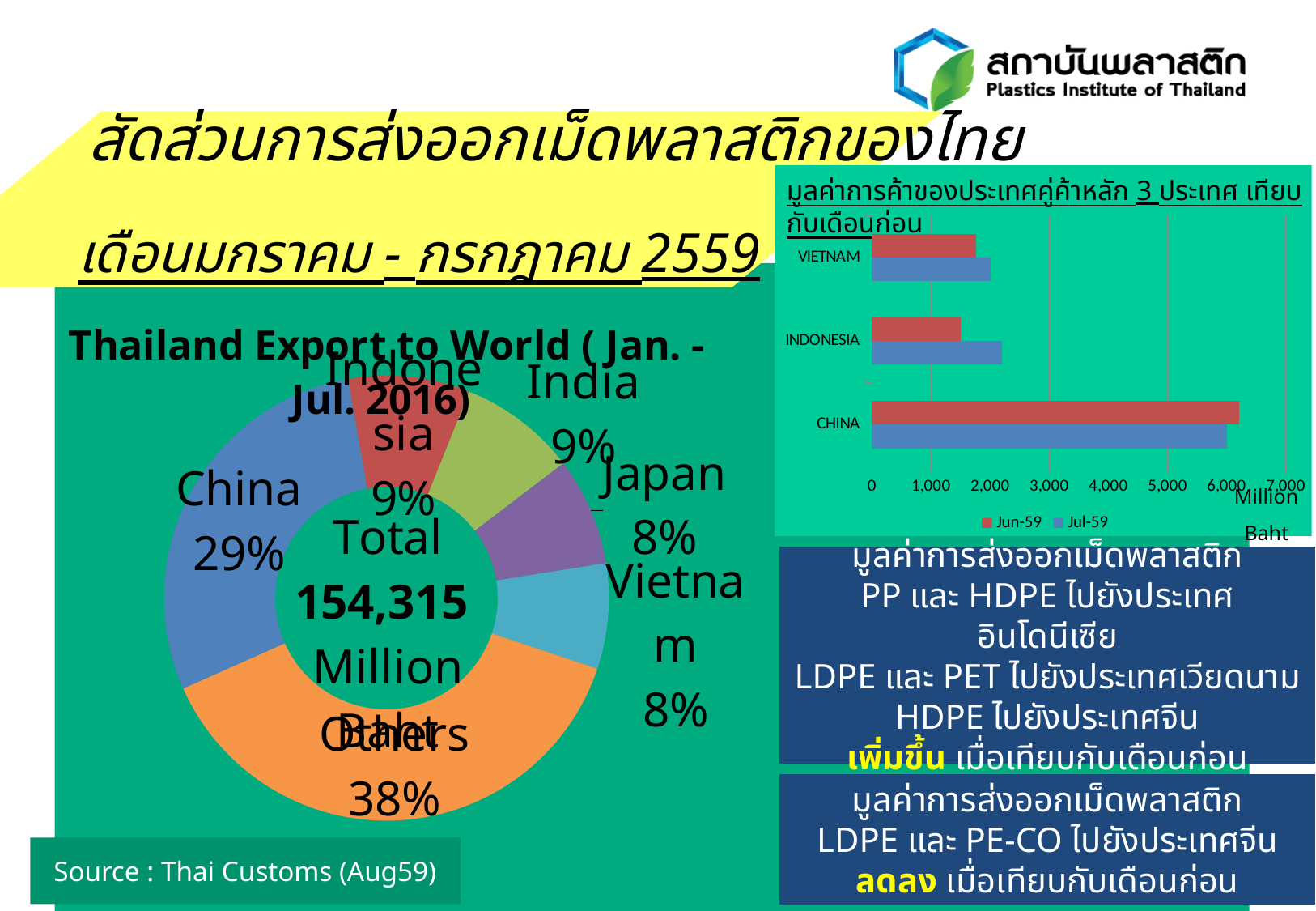
In the bar chart at the top right, is the Jun-59 value for CHINA greater or less than 5,000? greater In the doughnut chart 'Thailand Export to World (Jan. - Jul. 2016)', what total value is shown in the centre? 154,315 Million Baht In the doughnut chart 'Thailand Export to World (Jan. - Jul. 2016)', what share of exports goes to China? 29% What kind of chart is the one at the top right comparing VIETNAM, INDONESIA and CHINA? Bar chart In the bar chart at the top right, which country has the highest values? CHINA In the doughnut chart 'Thailand Export to World (Jan. - Jul. 2016)', which slice is the largest? Others In the doughnut chart 'Thailand Export to World (Jan. - Jul. 2016)', how many slices are there? 6 In the doughnut chart 'Thailand Export to World (Jan. - Jul. 2016)', what share is labelled Others? 38% In the bar chart at the top right, for INDONESIA, which is larger: Jun-59 or Jul-59? Jul-59 In the doughnut chart 'Thailand Export to World (Jan. - Jul. 2016)', how many percentage points larger is China's share than Japan's? 21 What kind of chart is 'Thailand Export to World (Jan. - Jul. 2016)'? Doughnut (pie) chart In the bar chart at the top right, how many series does the legend list? 2